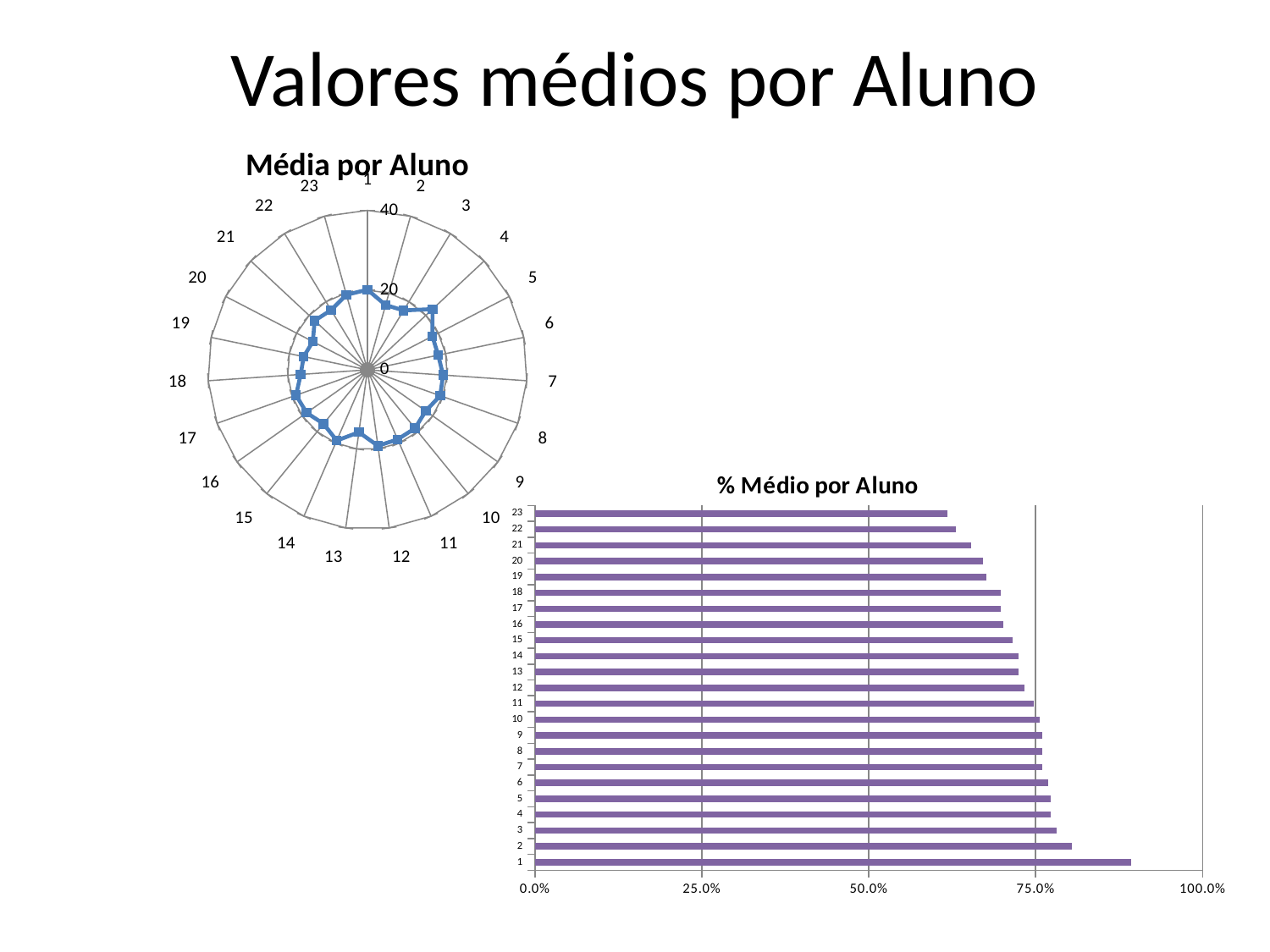
In the "% Médio por Aluno" chart, is the value for student 23 greater or less than 75.0%? less In the "% Médio por Aluno" chart, do the values rise or fall as the student number increases from 1 to 23? fall In the "% Médio por Aluno" chart, which student has the lowest value? 23 In the "% Médio por Aluno" chart, is the value for student 1 greater or less than 75.0%? greater How many categories are plotted around the "Média por Aluno" radar chart? 23 What kind of chart is the "% Médio por Aluno" chart? bar chart What kind of chart is the "Média por Aluno" chart? radar chart In the "% Médio por Aluno" chart, which is larger: the value for student 1 or the value for student 22? student 1 What is the maximum value shown on the axis of the "Média por Aluno" radar chart? 40 In the "% Médio por Aluno" chart, is the value for student 2 greater or less than 75.0%? greater In the "% Médio por Aluno" chart, which student has the highest value? 1 How many categories (students) are plotted in the "% Médio por Aluno" chart? 23